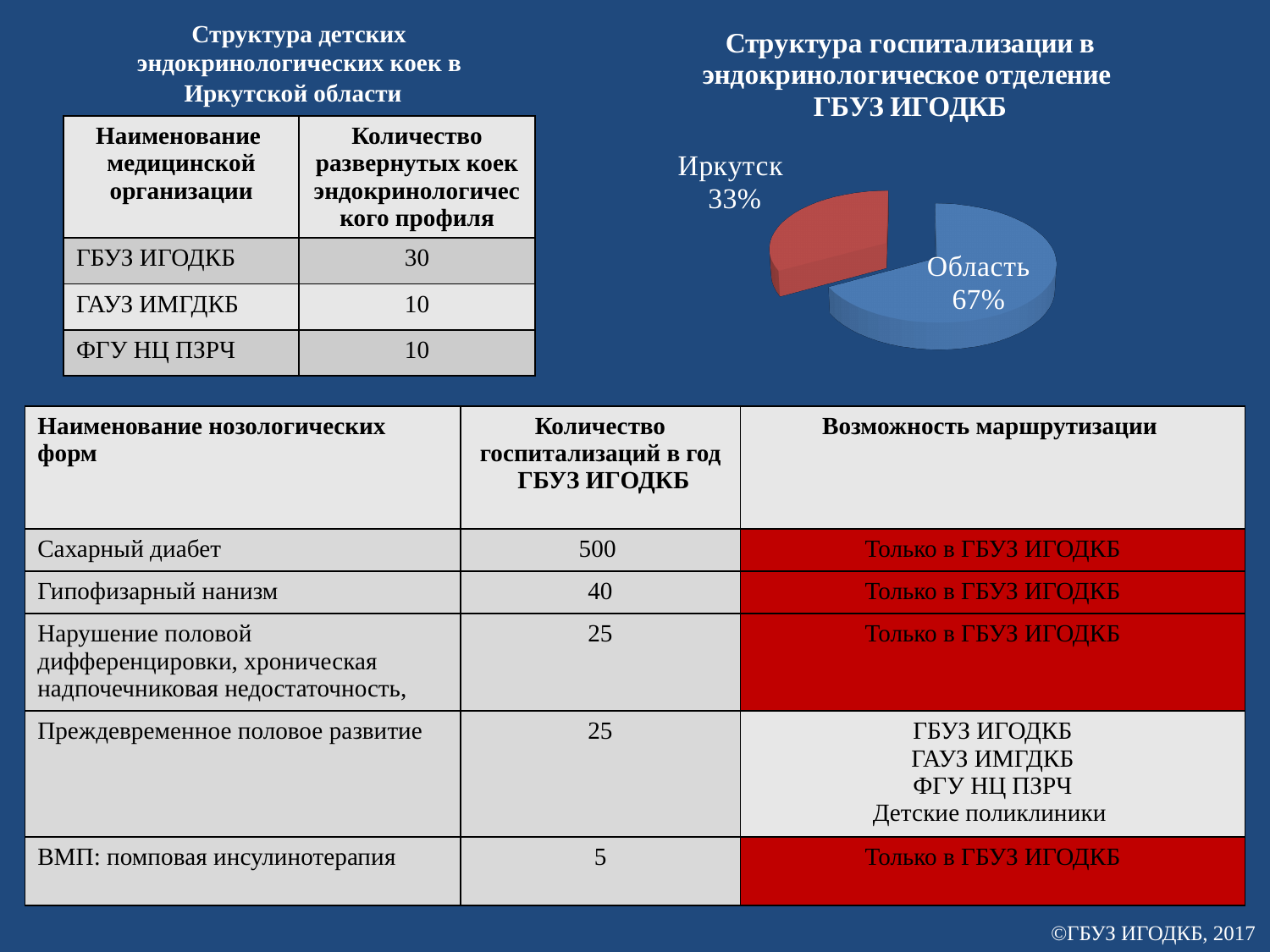
In the pie chart, which is larger: Иркутск or Область? Область What is the title of the pie chart? Структура госпитализации в эндокринологическое отделение ГБУЗ ИГОДКБ How many slices does the pie chart have? 2 What colour is the Иркутск slice in the pie chart? Red What share of the pie chart does Иркутск account for? 33% What share of the pie chart does Область account for? 67% What kind of chart is shown on the slide? Pie chart What is the difference in percentage points between the Область and Иркутск slices of the pie chart? 34 Which slice of the pie chart is the smallest? Иркутск Which slice of the pie chart is the largest? Область